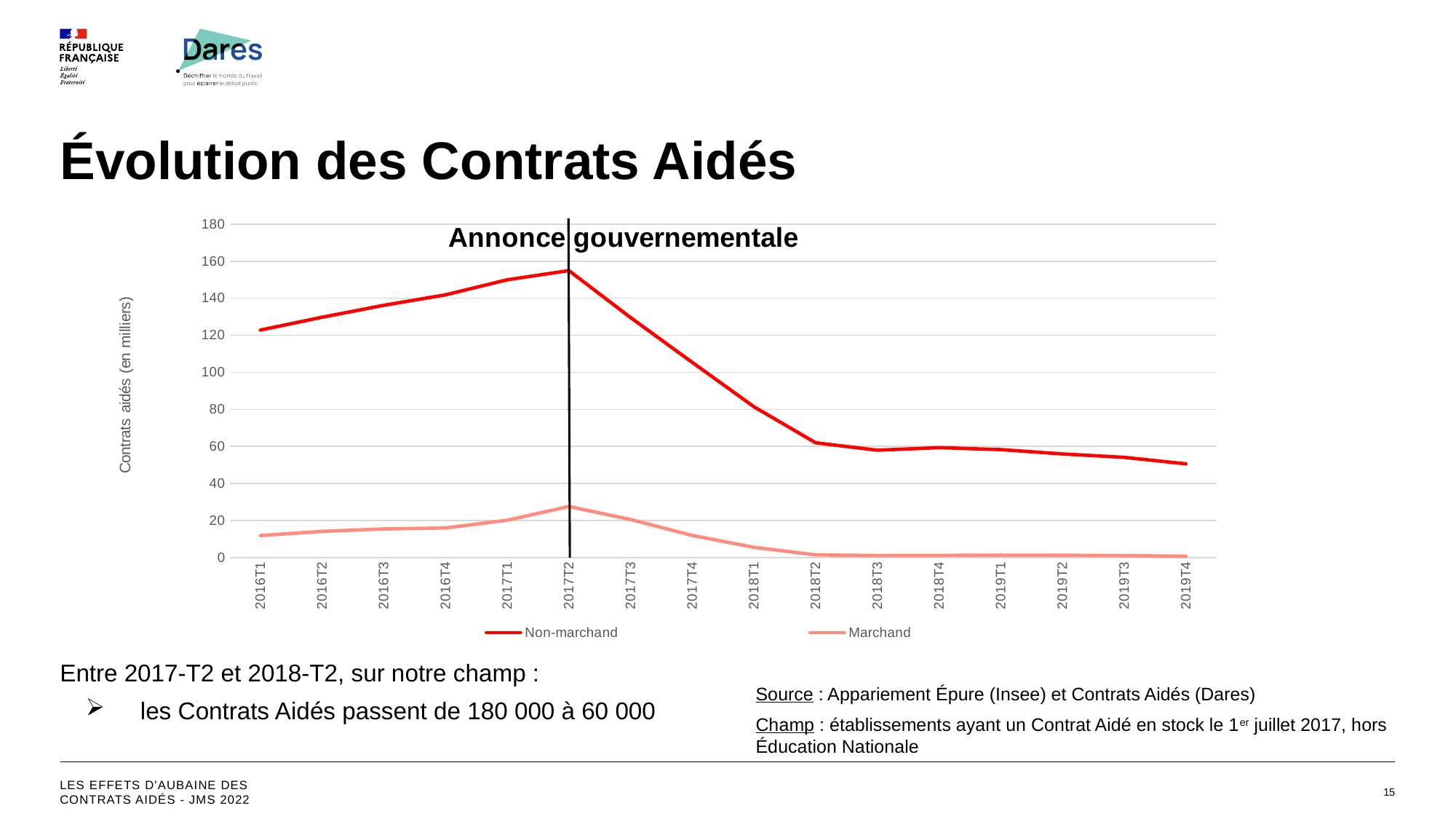
Is the value for Non-marchand in 2018T1 greater or less than 60? greater What label is shown on the vertical axis of the chart? Contrats aidés (en milliers) Which series has the larger value in 2017T2, Non-marchand or Marchand? Non-marchand How many quarters are plotted along the x axis? 16 In which quarter does the Non-marchand series reach its lowest value? 2019T4 In which quarter does the Non-marchand series reach its highest value? 2017T2 How many series does the legend list? 2 Does the Non-marchand series rise or fall between 2017T2 and 2018T2? Fall Is the value for Marchand in 2018T2 greater or less than 20? less What kind of chart is shown on the slide? Line chart Is the value for Non-marchand in 2016T1 greater or less than 100? greater In which quarter does the Marchand series reach its highest value? 2017T2